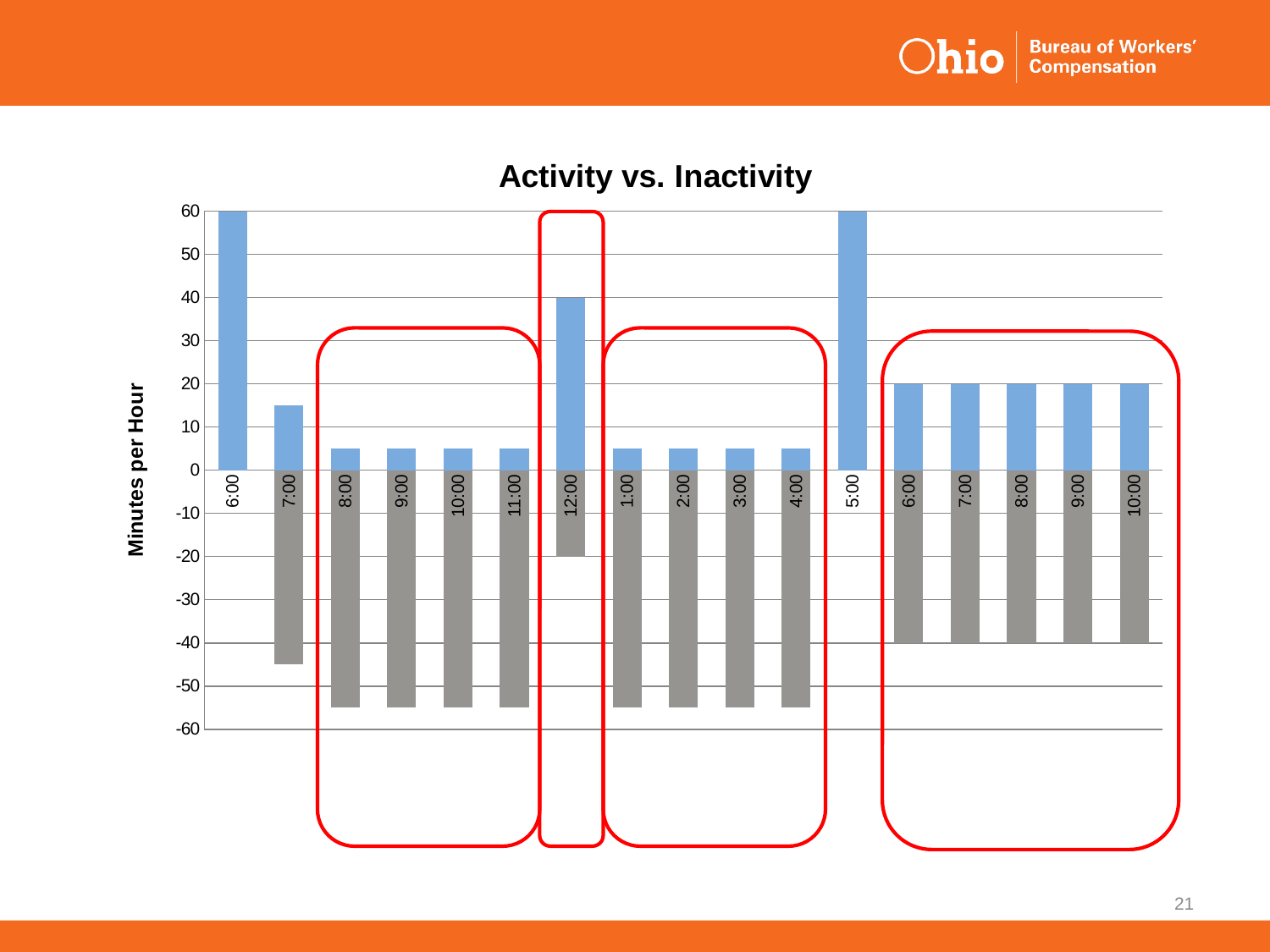
What is the value of the gray bar at the last category, 10:00 on the right? -40 What is the label on the vertical axis of the chart? Minutes per Hour Is the value of the blue bar at 8:00 (third category from the left) greater or less than 10? less What is the value of the blue bar at 12:00? 40 Which blue bar is larger, the one at 12:00 or the one at 2:00? 12:00 What is the value of the blue bar at the last category, 10:00 on the right? 20 What type of chart is shown on the slide? bar chart What is the value of the gray bar at 12:00? -20 How many time categories are shown along the x axis of the chart? 17 What is the value of the blue bar at 5:00? 60 Is the value of the blue bar at 7:00 (second category from the left) greater or less than 10? greater What is the title of the chart? Activity vs. Inactivity